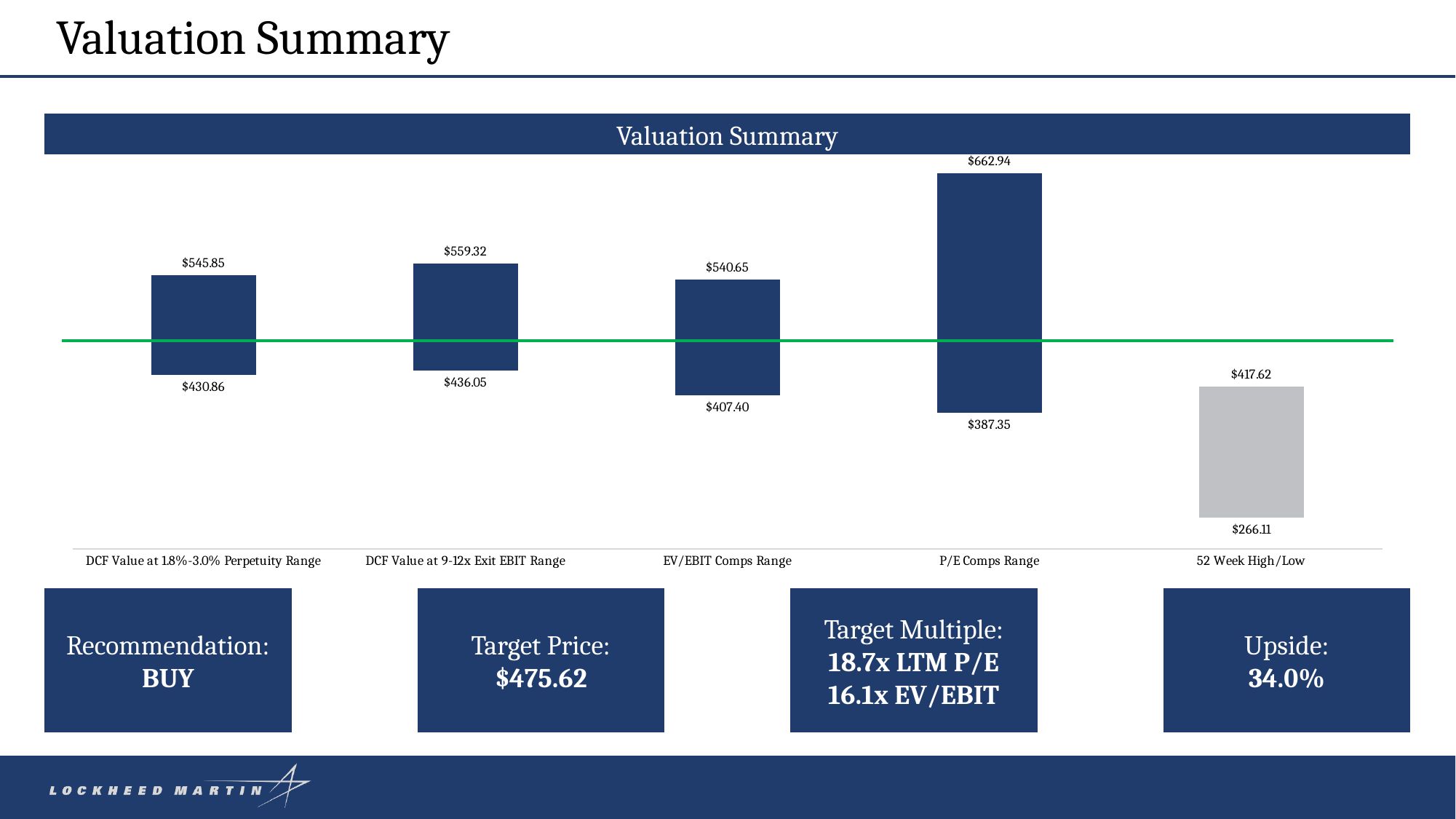
What kind of chart is shown on the slide? Bar chart What is the low value shown for the EV/EBIT Comps Range? $407.40 Which is larger, the high value of the DCF Value at 9-12x Exit EBIT Range or the high value of the EV/EBIT Comps Range? DCF Value at 9-12x Exit EBIT Range What is the high value shown for the DCF Value at 9-12x Exit EBIT Range? $559.32 What is the high value shown for the P/E Comps Range? $662.94 Which category has the highest upper value in the chart? P/E Comps Range What is the difference between the high and low values of the 52 Week High/Low bar? $151.51 Which category has the lowest lower value in the chart? 52 Week High/Low What is the low value shown for the 52 Week High/Low bar? $266.11 What is the difference between the high and low values of the P/E Comps Range? $275.59 What is the low value shown for the DCF Value at 1.8%-3.0% Perpetuity Range? $430.86 How many categories are shown on the x axis of the chart? 5